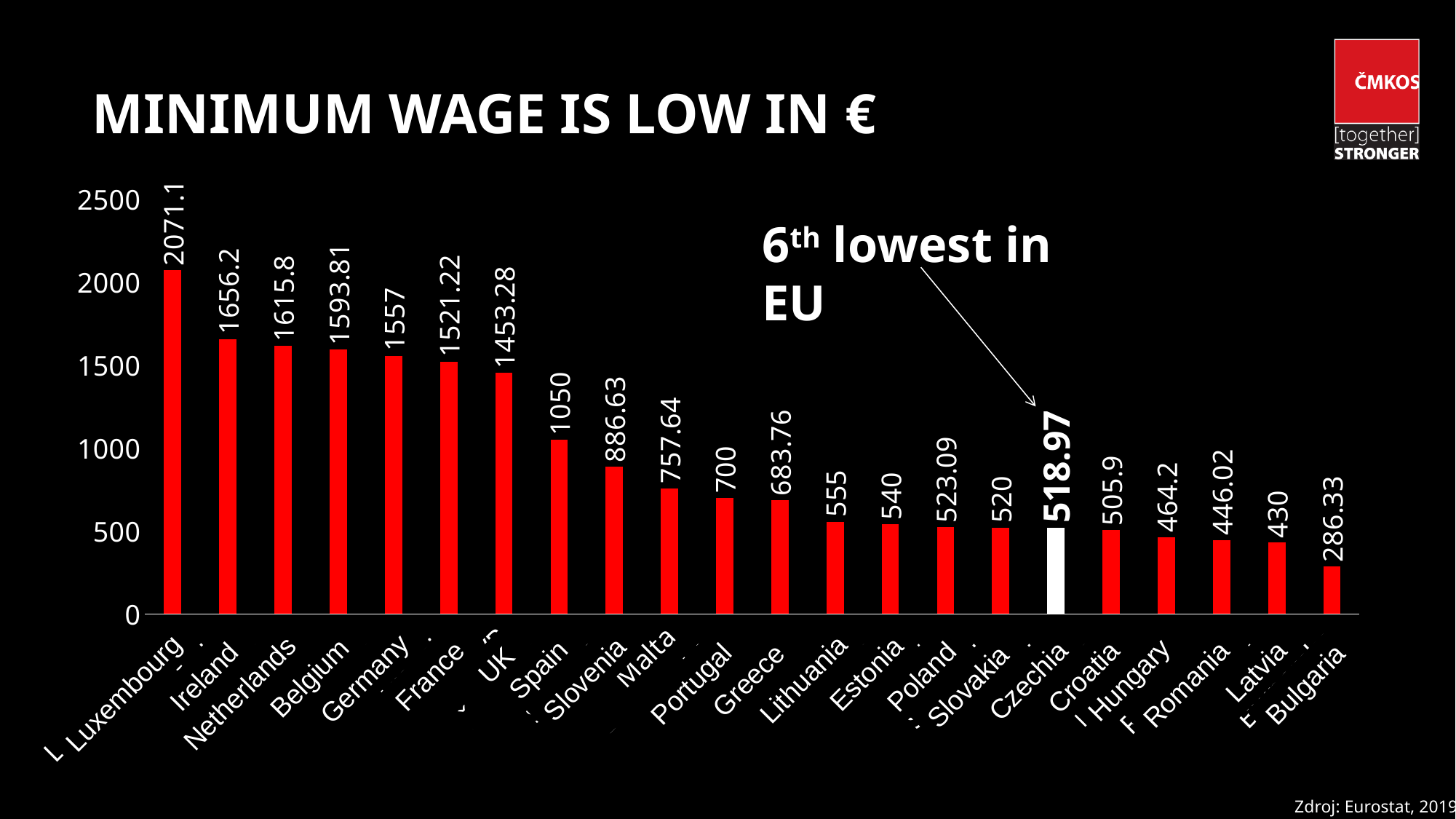
What is the difference between the values for Spain and Portugal? 350 What is the value shown for Germany? 1557 What kind of chart is shown on the slide? Bar chart Which country has the lowest minimum wage on the chart? Bulgaria How many countries are shown on the chart? 22 Which country has the highest minimum wage on the chart? Luxembourg What is the difference between the values for Luxembourg and Ireland? 414.9 Is the value for Greece greater or less than 500? greater What is the value shown for Bulgaria? 286.33 Which has a higher value, Slovenia or Malta? Slovenia What is the minimum wage value shown for Czechia? 518.97 Do the values rise or fall from left to right along the x axis? Fall